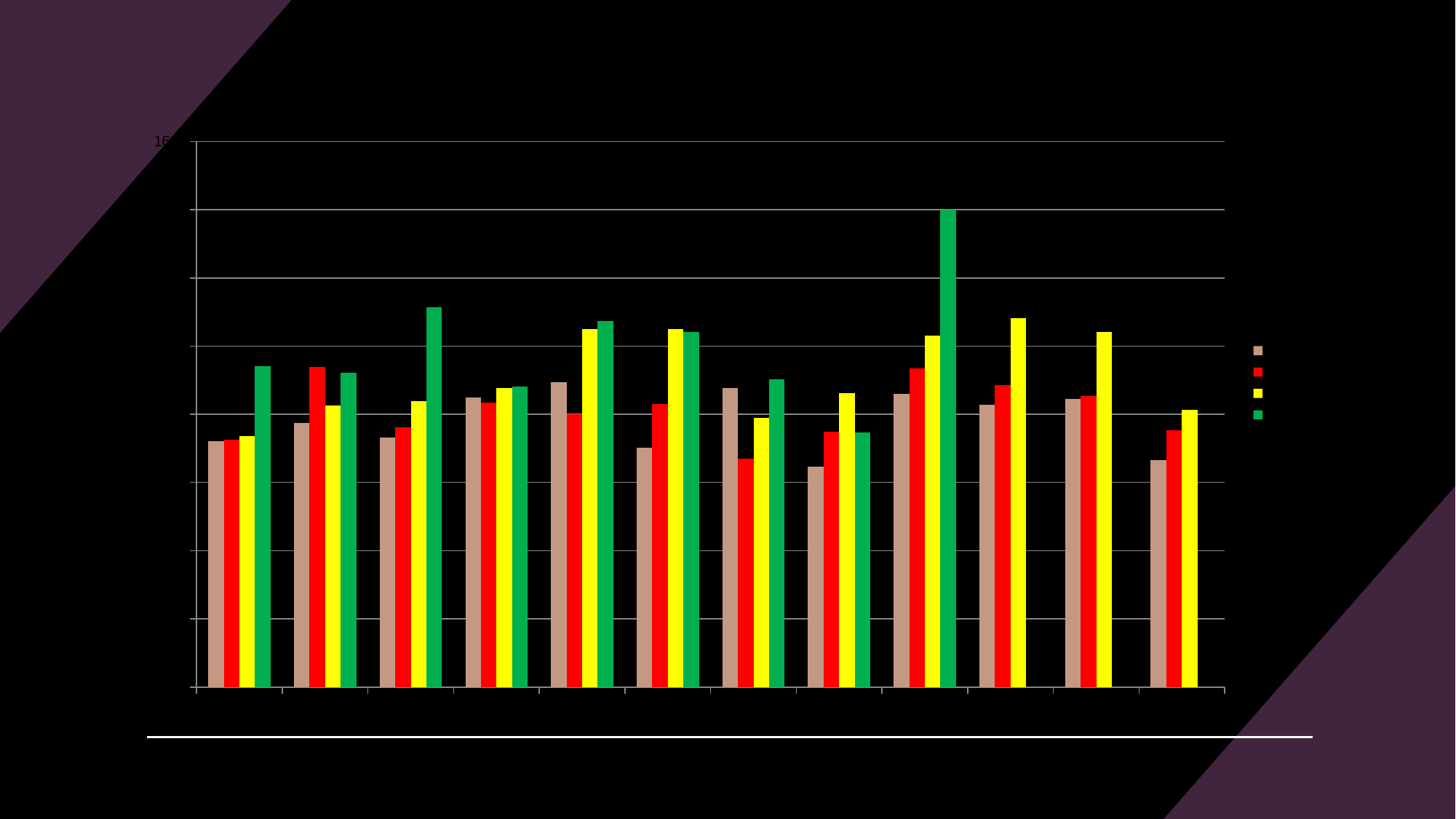
What colours are the four series in the legend, from top to bottom? tan, red, yellow, green How many groups of bars (categories) are plotted along the x axis? 12 In the second group from the left, which bar is taller, the red one or the tan one? the red one Which series has the shortest bar in the eighth group from the left? the tan series What kind of chart is shown on the slide? bar chart How many series does the legend list? 4 Which group of bars contains the tallest bar on the chart? the ninth group from the left Which series does the tallest bar on the chart belong to? the green series In the rightmost group, which bar is taller, the yellow one or the tan one? the yellow one How many groups of bars have no green bar? 3 In the leftmost group, which bar is taller, the green one or the tan one? the green one